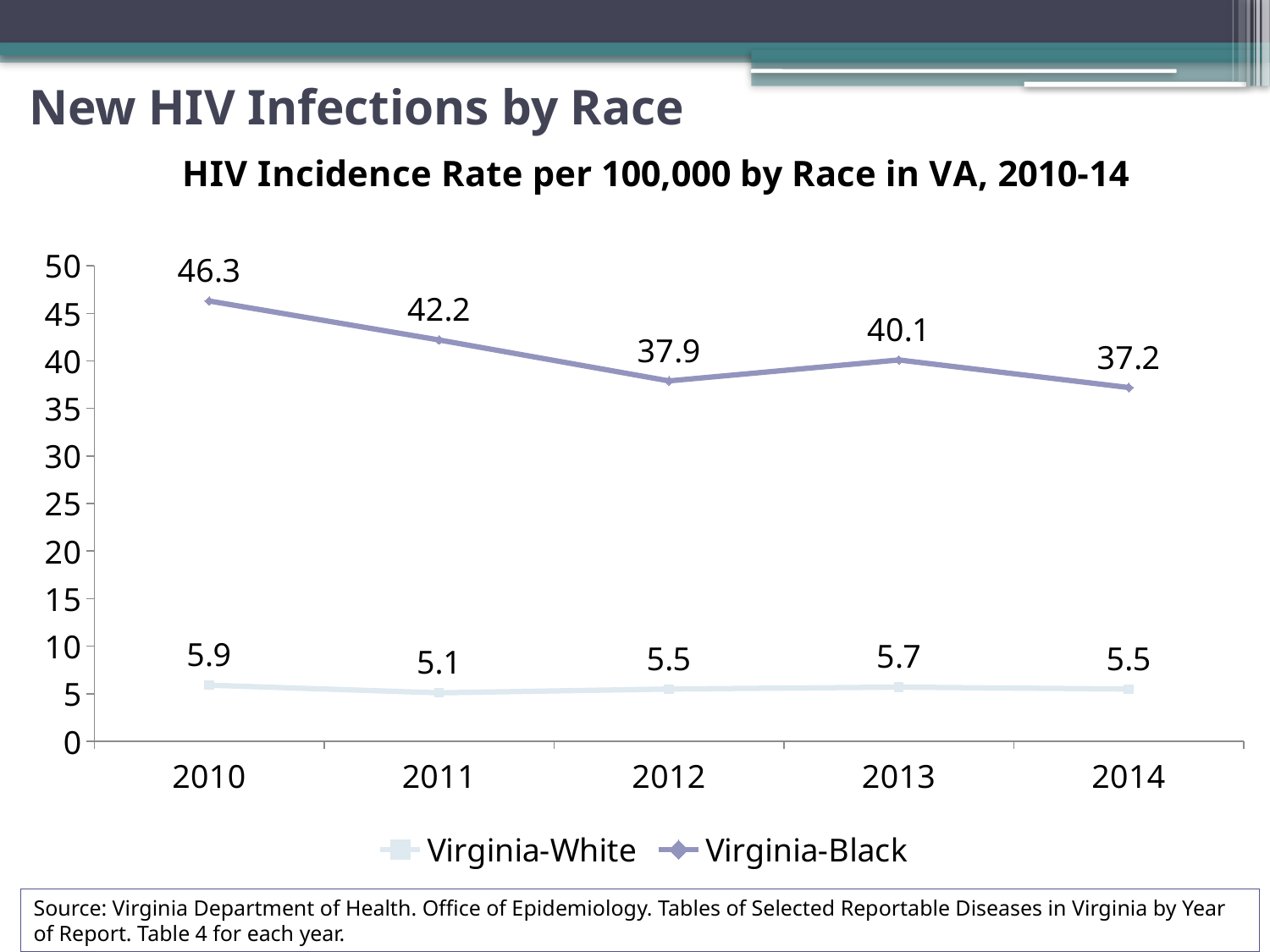
In which year is the Virginia-White rate lowest? 2011 What is the difference between the Virginia-Black and Virginia-White rates in 2012? 32.4 Which is larger, the Virginia-Black rate in 2012 or in 2013? 2013 In which year is the Virginia-Black rate highest? 2010 What is the HIV incidence rate for Virginia-White in 2013? 5.7 What is the HIV incidence rate for Virginia-Black in 2014? 37.2 What is the HIV incidence rate for Virginia-Black in 2010? 46.3 What kind of chart is shown? Line chart By how much did the Virginia-Black rate fall from 2010 to 2014? 9.1 How many series does the legend list? 2 How many years are shown on the x axis? 5 What is the title of the chart? HIV Incidence Rate per 100,000 by Race in VA, 2010-14